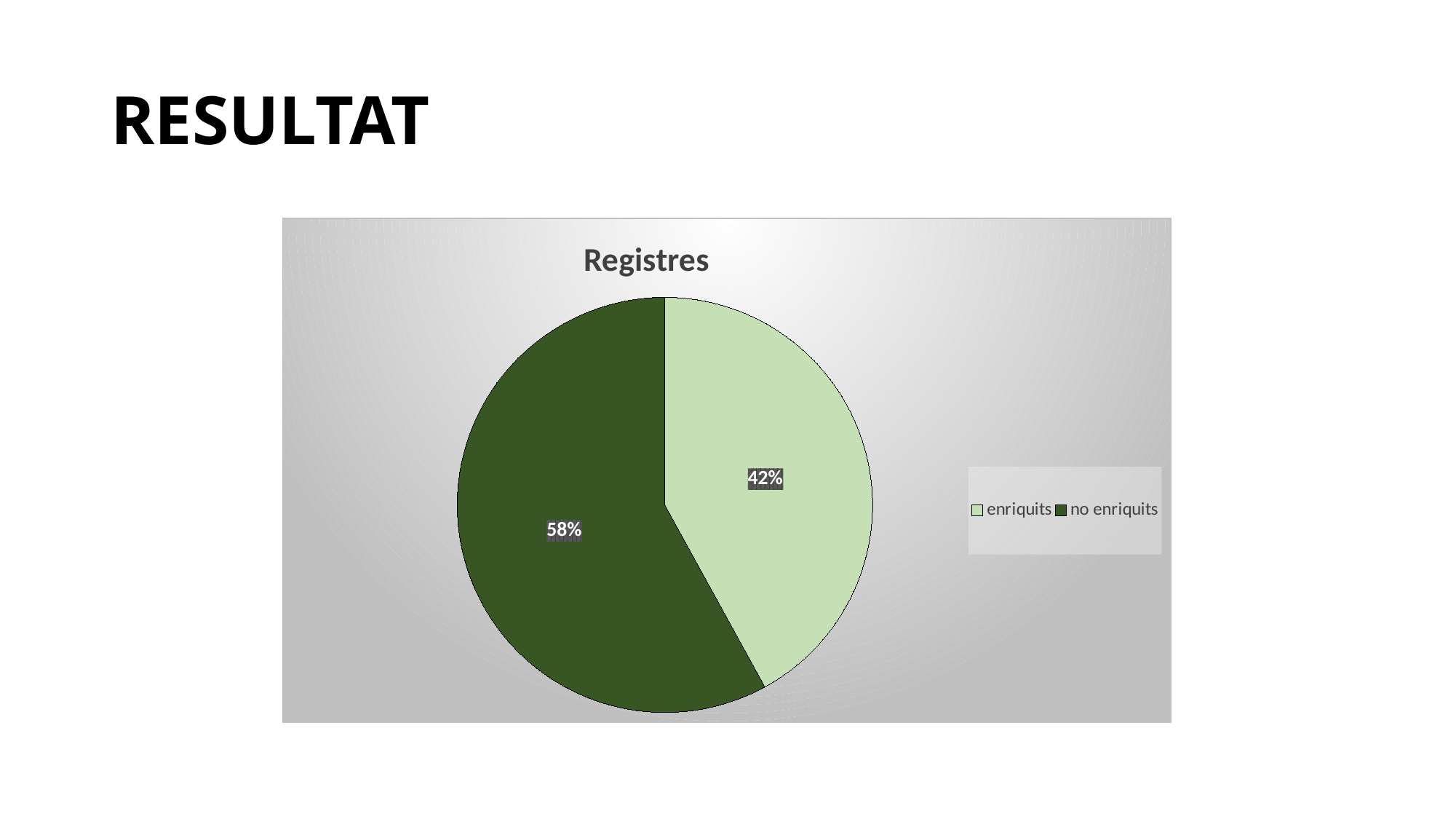
Is the share for 'enriquits' greater or less than 50%? less What share of the pie does the 'no enriquits' slice represent? 58% What is the title of the chart? Registres Which is larger, the 'enriquits' slice or the 'no enriquits' slice? no enriquits What share of the pie does the 'enriquits' slice represent? 42% Which legend entry is shown in dark green? no enriquits What is the difference in percentage points between the 'no enriquits' and 'enriquits' slices? 16 How many slices does the pie chart have? 2 How many entries does the legend list? 2 Which slice is the smallest in the pie chart? enriquits Which slice is the largest in the pie chart? no enriquits What kind of chart is shown on the slide? pie chart